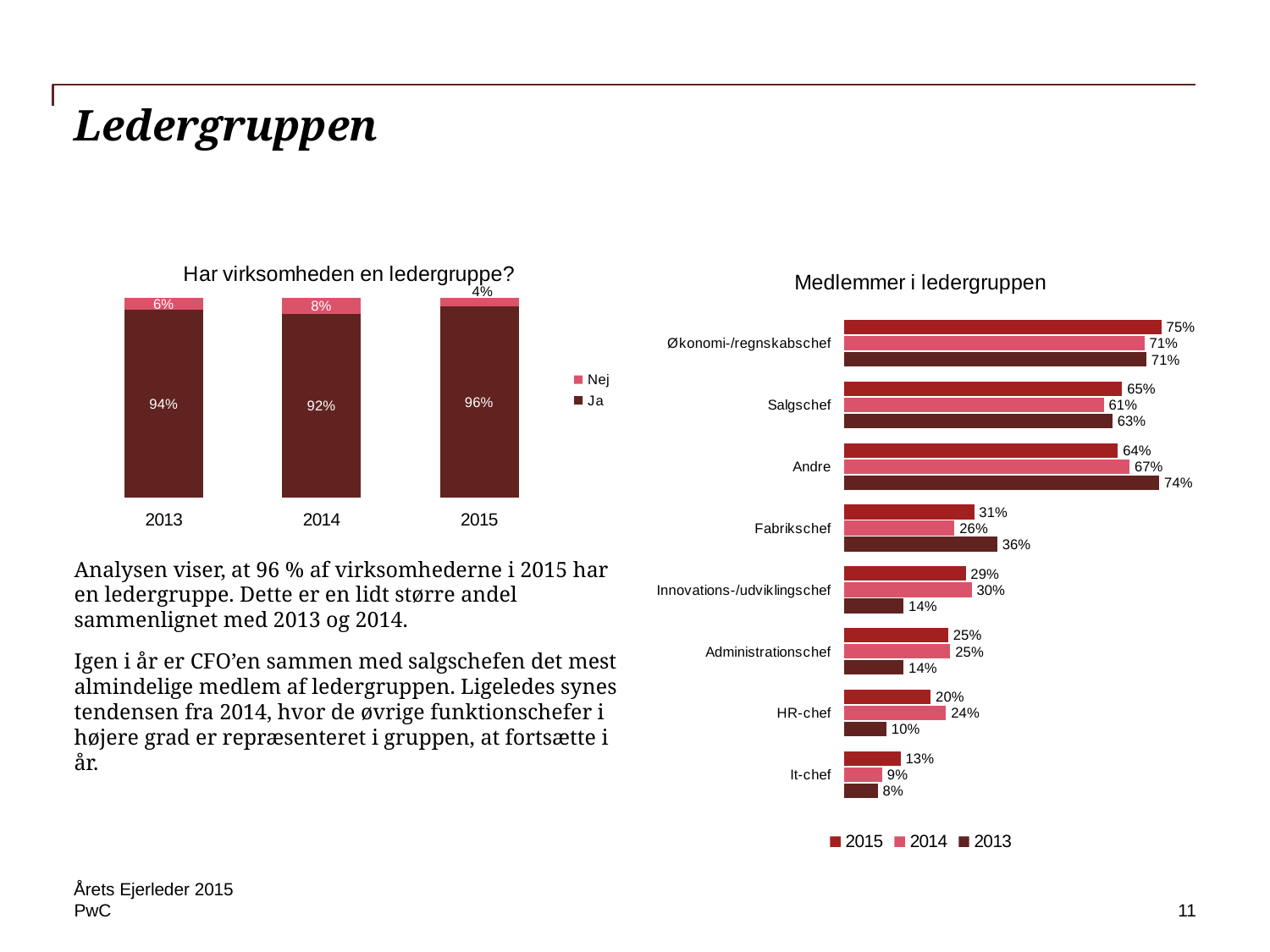
In the chart 'Har virksomheden en ledergruppe?', what is the 'Ja' value for 2015? 96% In the chart 'Medlemmer i ledergruppen', is the 2014 value for HR-chef larger or smaller than the 2013 value for HR-chef? larger In the chart 'Har virksomheden en ledergruppe?', how many series does the legend list? 2 In the chart 'Medlemmer i ledergruppen', how many categories are shown? 8 In the chart 'Har virksomheden en ledergruppe?', what is the 'Nej' value for 2014? 8% In the chart 'Har virksomheden en ledergruppe?', what is the total of the stacked bar for 2013? 100% In the chart 'Medlemmer i ledergruppen', what is the difference between the 2013 and 2015 values for Andre? 10% In the chart 'Har virksomheden en ledergruppe?', which year has the lowest 'Ja' share? 2014 In the chart 'Medlemmer i ledergruppen', which category has the highest 2015 value? Økonomi-/regnskabschef In the chart 'Medlemmer i ledergruppen', what is the 2015 value for Salgschef? 65% In the chart 'Medlemmer i ledergruppen', which category has the lowest 2014 value? It-chef In the chart 'Medlemmer i ledergruppen', what is the 2013 value for Innovations-/udviklingschef? 14%